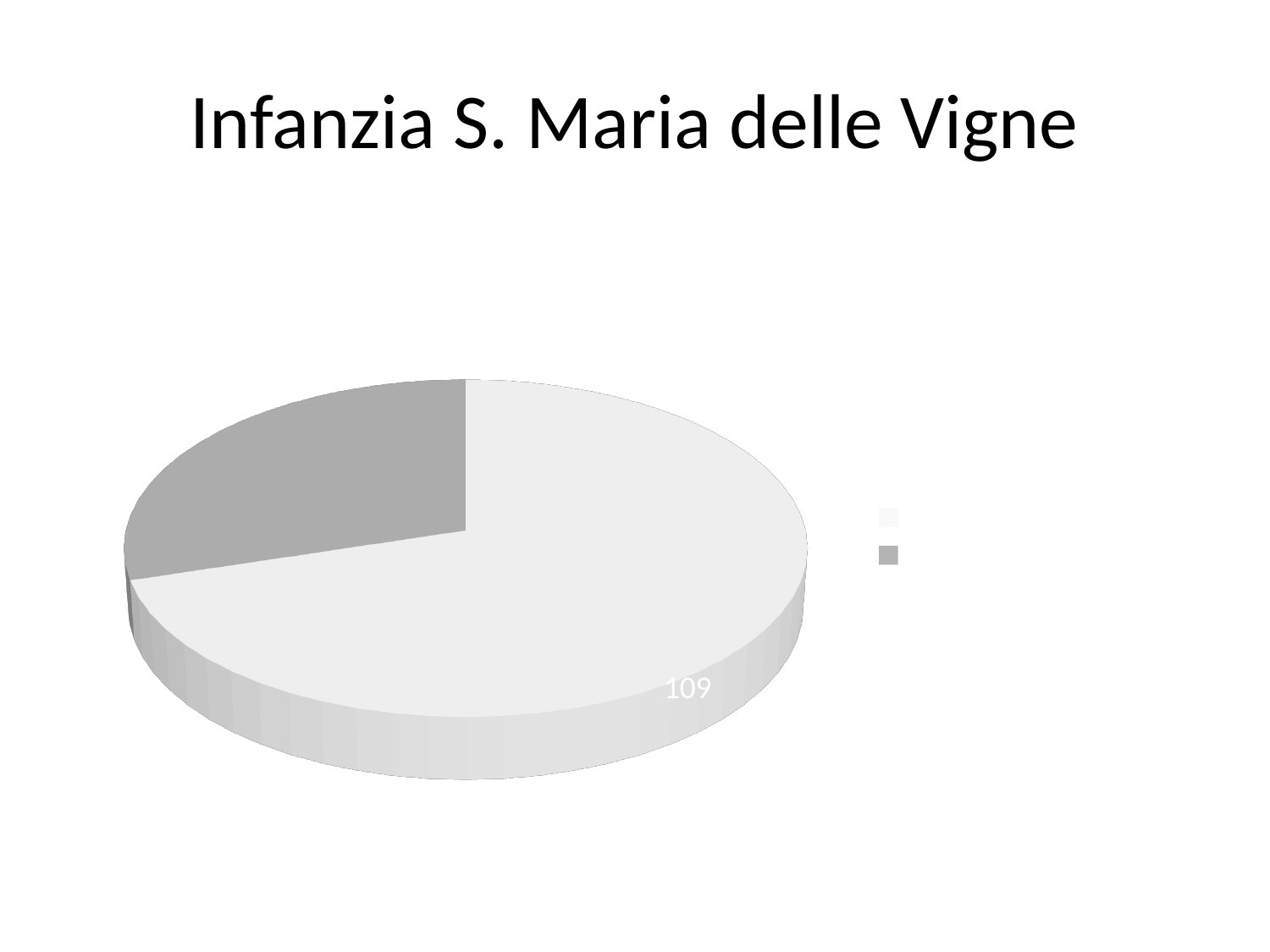
What value is printed on the large light grey slice of the pie chart? 109 What is the title of the slide containing the pie chart? Infanzia S. Maria delle Vigne Which slice of the pie chart is the smallest? the dark grey slice How many entries does the legend of the pie chart list? 2 Is the pie chart drawn in 3D or flat 2D? 3D What kind of chart is shown on the slide? pie chart How many slices does the pie chart have? 2 Which slice of the pie chart is larger, the light grey one or the dark grey one? the light grey one